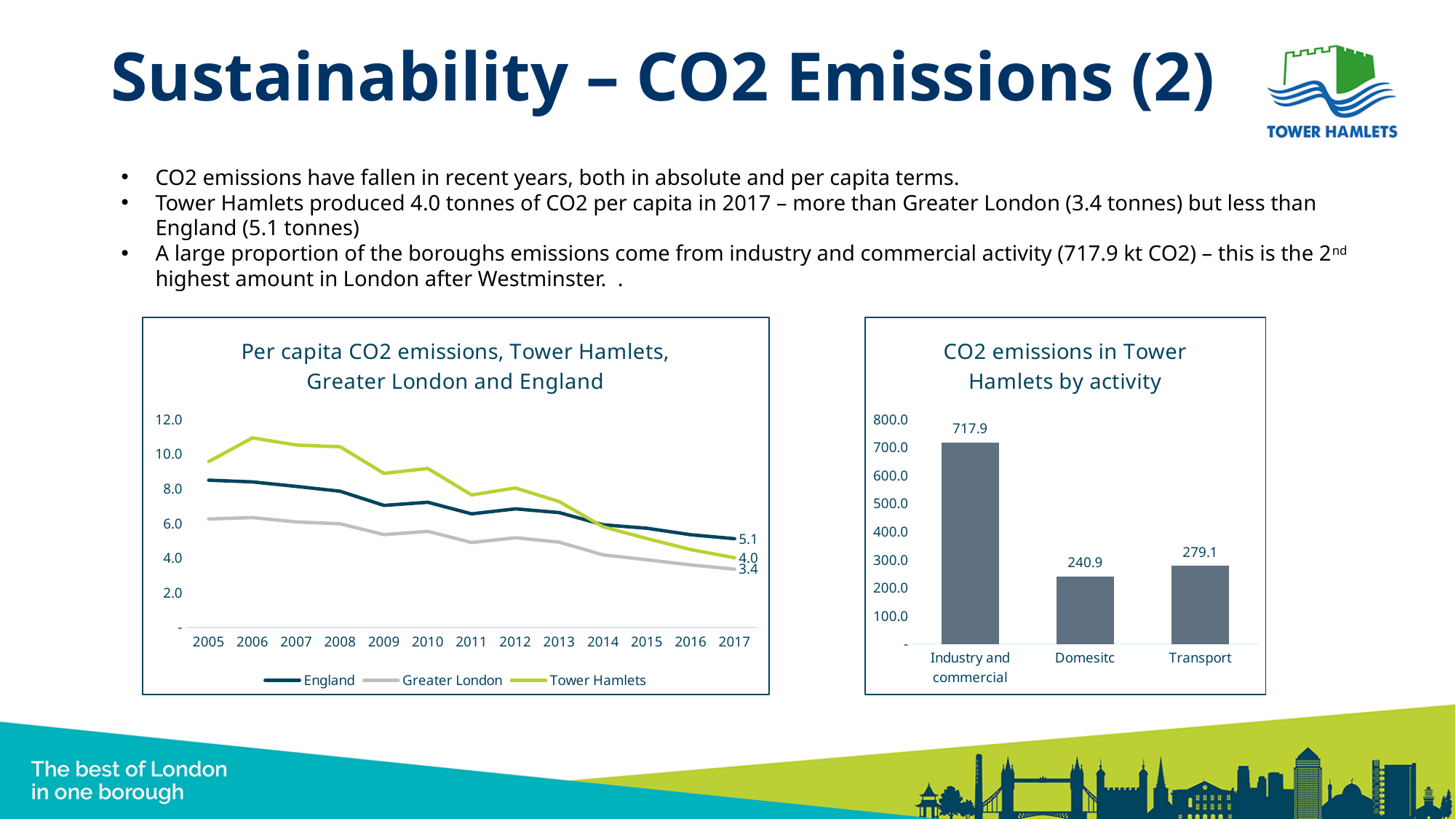
What kind of chart is 'CO2 emissions in Tower Hamlets by activity'? bar chart In the 'CO2 emissions in Tower Hamlets by activity' chart, how many activity categories are shown? 3 In the 'CO2 emissions in Tower Hamlets by activity' chart, which activity has the lowest emissions? Domesitc In the 'Per capita CO2 emissions' chart, which series is shown in green? Tower Hamlets In the 'Per capita CO2 emissions' chart, how many series does the legend list? 3 In the 'Per capita CO2 emissions' chart, what is the value for England in 2017? 5.1 In the 'CO2 emissions in Tower Hamlets by activity' chart, what is the difference between Industry and commercial and Transport? 438.8 In the 'CO2 emissions in Tower Hamlets by activity' chart, what is the value for Transport? 279.1 In the 'Per capita CO2 emissions' chart, does the Tower Hamlets series rise or fall from 2006 to 2017? fall In the 'CO2 emissions in Tower Hamlets by activity' chart, what is the value for Industry and commercial? 717.9 In the 'Per capita CO2 emissions' chart, is the value for Tower Hamlets in 2005 greater or less than 8.0? greater In the 'Per capita CO2 emissions' chart, what is the value for Greater London in 2017? 3.4